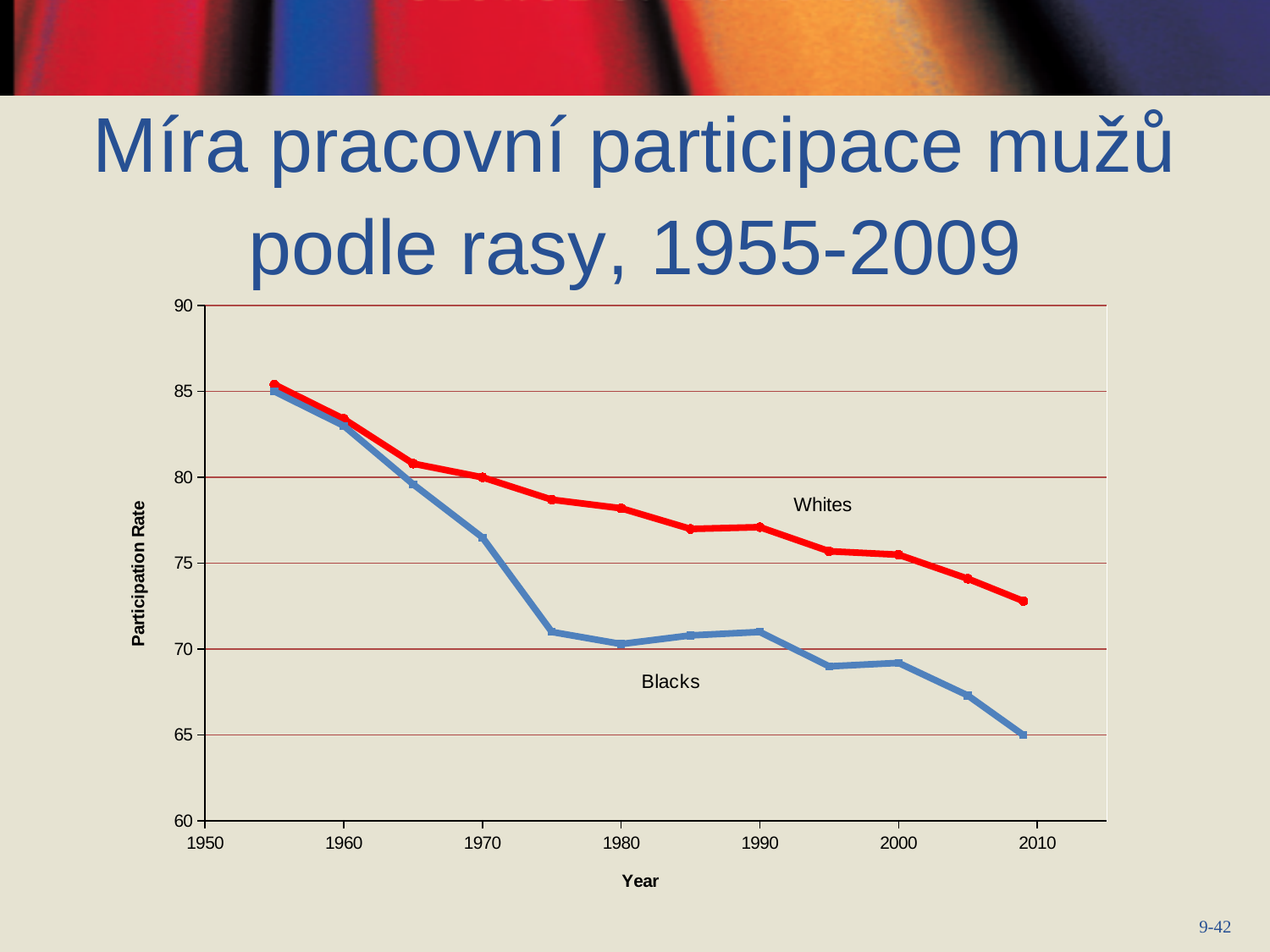
Is the value for Whites in 2009 greater or less than 75? less In 1990, which series has the higher participation rate, Whites or Blacks? Whites Is the value for Blacks in 1975 greater or less than 75? less What is the label of the vertical axis? Participation Rate Is the value for Blacks in 1955 greater or less than 80? greater What are the two series labelled on the chart? Whites and Blacks What kind of chart is shown on the slide? line chart How many data series are plotted on the chart? 2 Do the participation rates for Blacks rise or fall from 1955 to 2009? fall